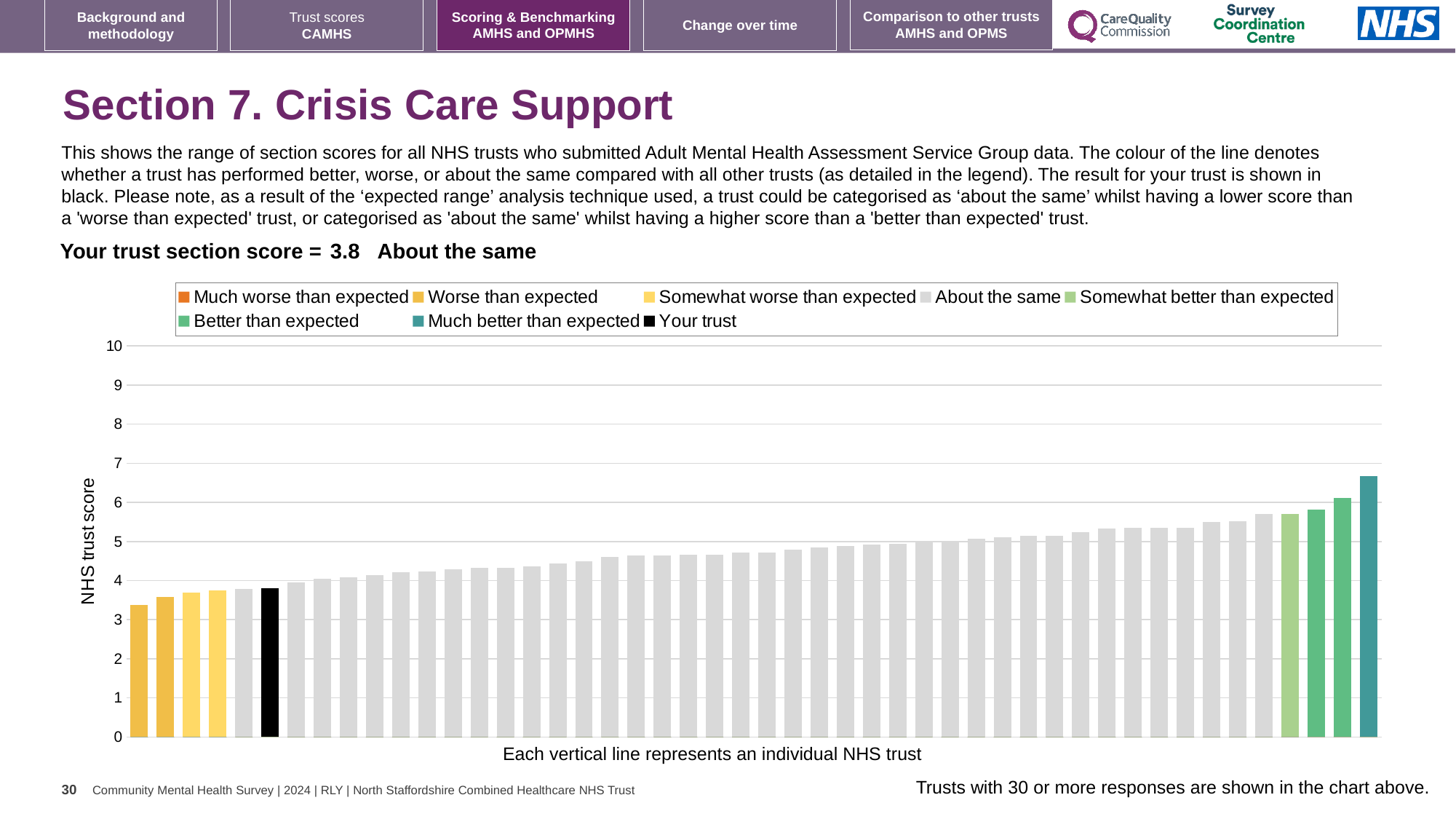
What kind of chart is shown on the slide? bar chart Is the value of the black 'Your trust' bar greater or less than 4? less Which legend category does the tallest bar in the chart belong to? Much better than expected Is the value of the tallest bar in the chart greater or less than 6? greater What is the section score for your trust shown on the slide? 3.8 How many bars in the chart are coloured as 'Much better than expected'? 1 How many entries does the chart legend list? 8 Is the value of the shortest bar in the chart greater or less than 4? less What is the label on the vertical axis of the chart? NHS trust score Do the bar values rise or fall from left to right across the chart? rise Which performance category is your trust placed in according to the slide? About the same